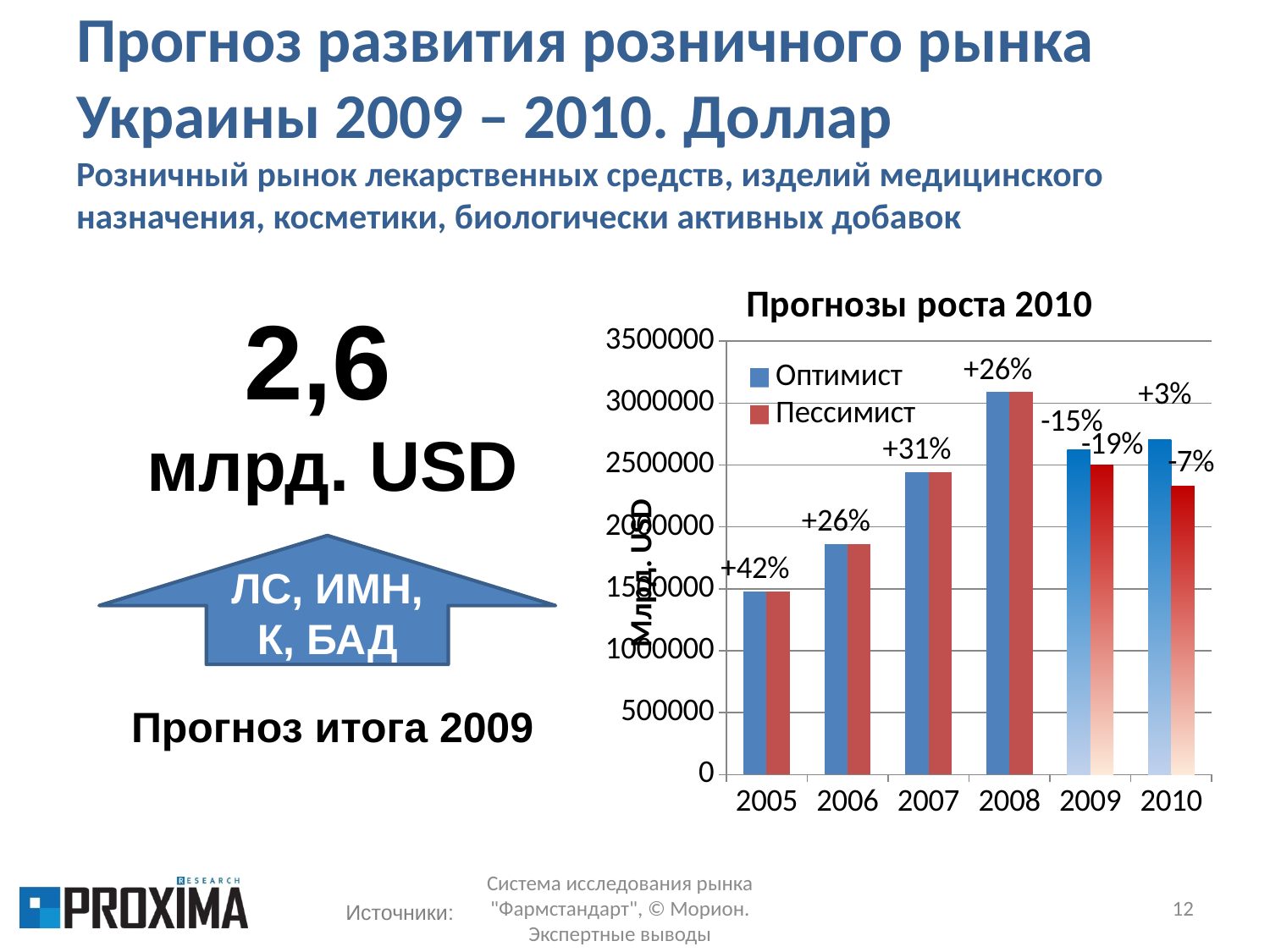
What kind of chart is shown under the title 'Прогнозы роста 2010'? bar chart In the 'Прогнозы роста 2010' chart, which is larger for 2010: the Оптимист bar or the Пессимист bar? Оптимист What growth percentage is labelled for 2005 in the 'Прогнозы роста 2010' chart? +42% What growth percentage is labelled for 2007 in the 'Прогнозы роста 2010' chart? +31% Which year has the highest bars in the 'Прогнозы роста 2010' chart? 2008 In the 'Прогнозы роста 2010' chart, what growth percentage is labelled for the Оптимист series in 2009? -15% In the 'Прогнозы роста 2010' chart, is the Пессимист value for 2010 greater or less than 2500000? less How many years are shown on the x axis of the 'Прогнозы роста 2010' chart? 6 In the 'Прогнозы роста 2010' chart, what growth percentage is labelled for the Пессимист series in 2010? -7% How many series does the legend of the 'Прогнозы роста 2010' chart list? 2 Which year has the lowest bars in the 'Прогнозы роста 2010' chart? 2005 In the 'Прогнозы роста 2010' chart, is the value for 2008 greater or less than 3000000? greater